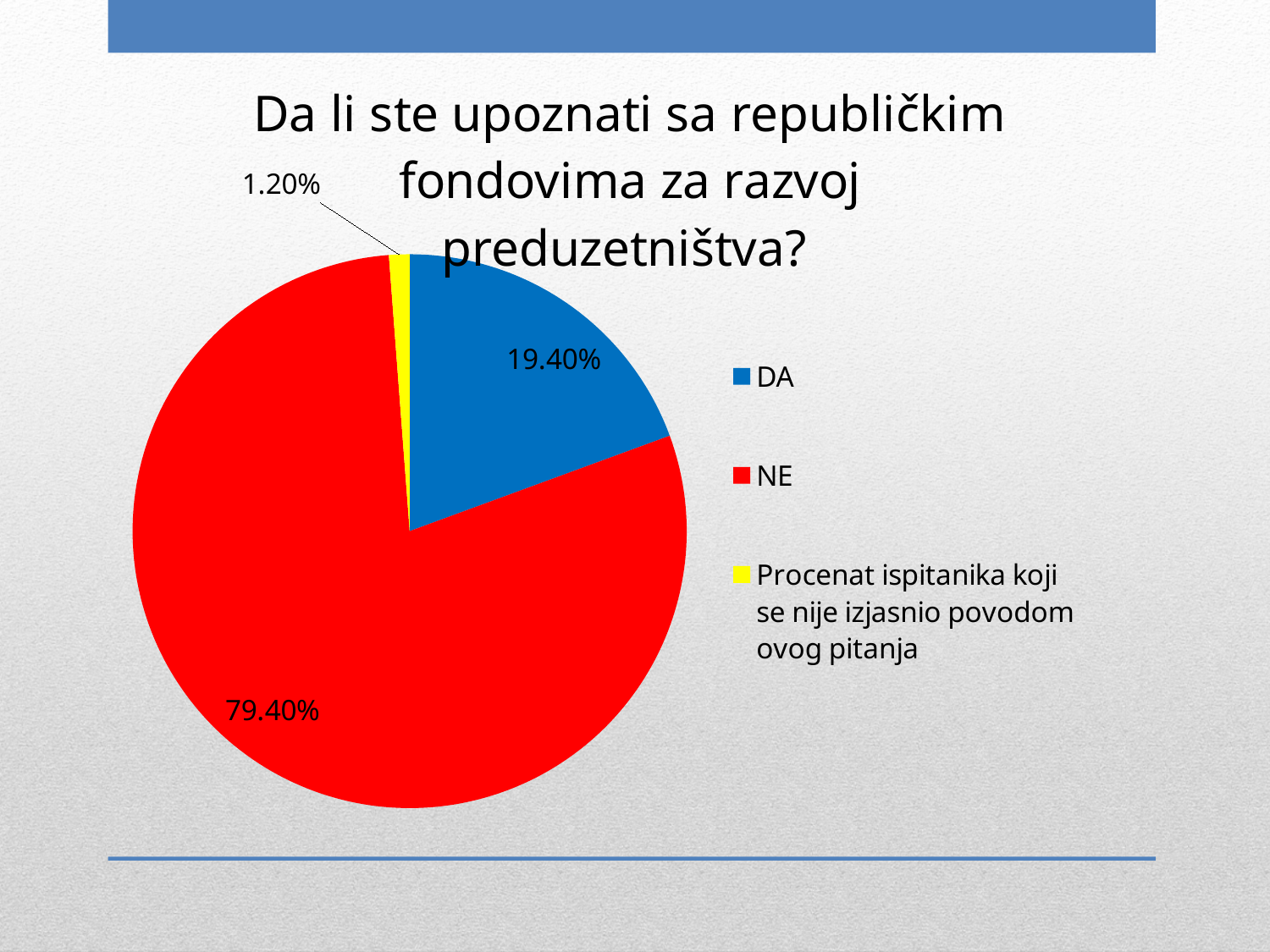
Which category has the smallest share of the pie? Procenat ispitanika koji se nije izjasnio povodom ovog pitanja What is the value for DA? 19.40% How many slices does the pie chart have? 3 Which is larger, the value for DA or the value for NE? NE What type of chart is shown on the slide? pie chart What colour is the slice for NE? red What is the value for the slice representing respondents who did not answer (Procenat ispitanika koji se nije izjasnio povodom ovog pitanja)? 1.20% What is the difference between the NE and DA values? 60.00% Which category has the largest share of the pie? NE What is the value for NE? 79.40% What is the title of the chart? Da li ste upoznati sa republičkim fondovima za razvoj preduzetništva? How many entries does the legend list? 3